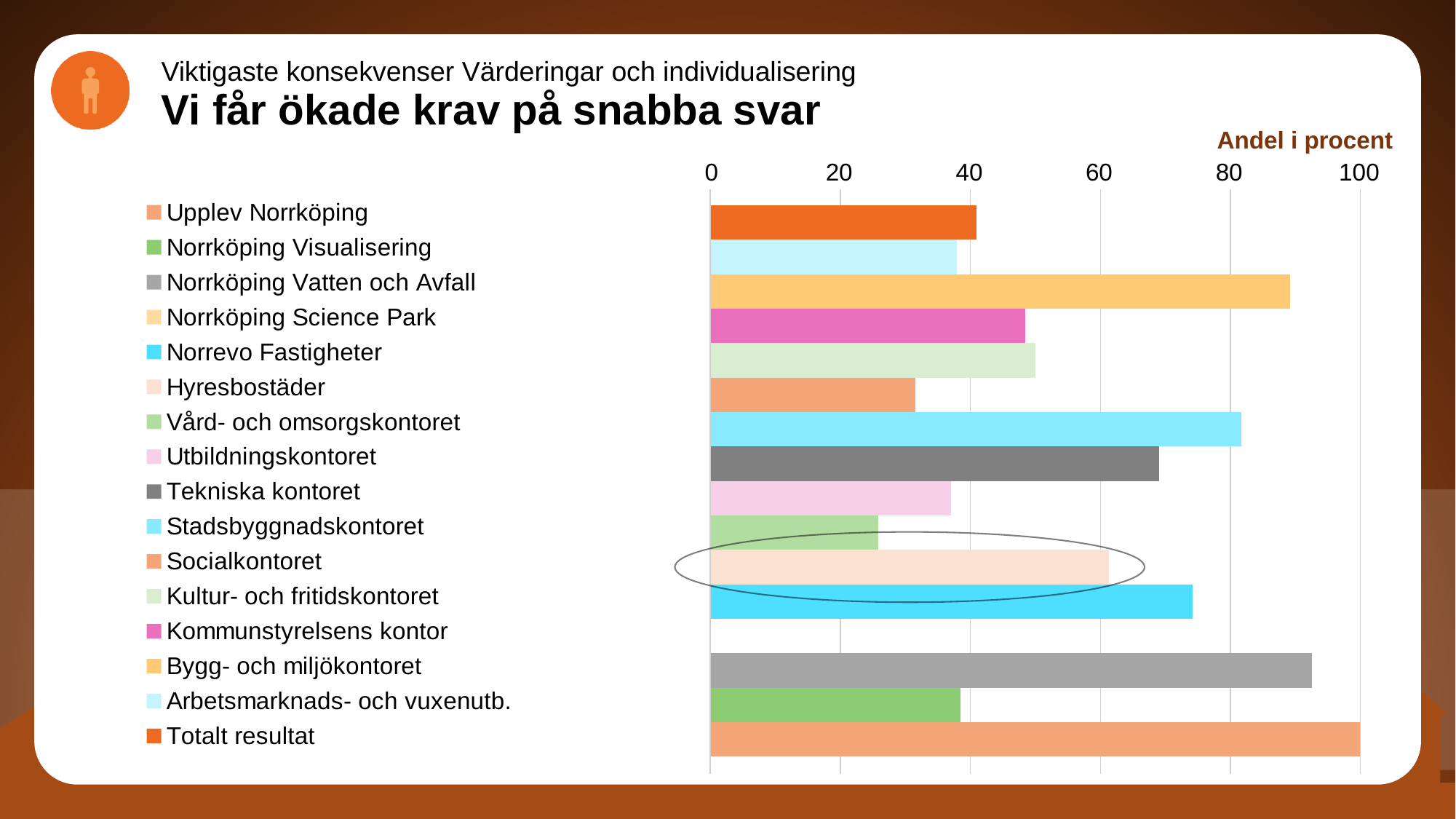
Is the value for Socialkontoret greater or less than 40? less Which category has the shortest visible bar in the chart? Vård- och omsorgskontoret Which is larger, the value for Kultur- och fritidskontoret or the value for Socialkontoret? Kultur- och fritidskontoret Is the value for Bygg- och miljökontoret greater or less than 80? greater Which category has the longest bar in the chart? Upplev Norrköping How many categories are listed in the chart legend? 16 What label is shown above the horizontal axis of the chart? Andel i procent Is the value for Tekniska kontoret greater or less than 60? greater Which is larger, the value for Stadsbyggnadskontoret or the value for Tekniska kontoret? Stadsbyggnadskontoret What is the value for Upplev Norrköping? 100 What kind of chart is shown on the slide? bar chart